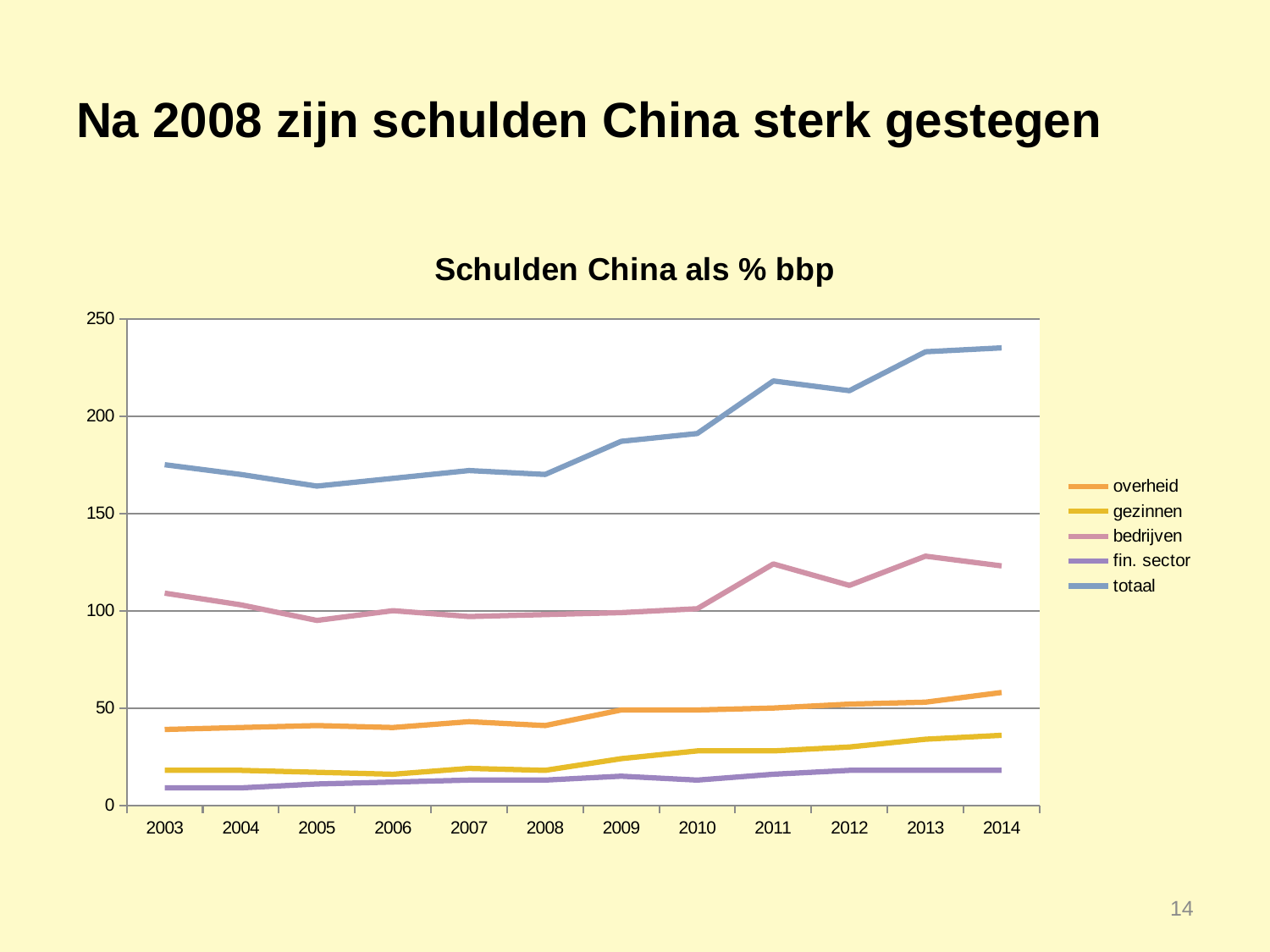
How many series does the legend list? 5 Which series has the lowest value in 2014? fin. sector What is the title of the chart? Schulden China als % bbp Is the value for totaal in 2005 greater or less than 200? less Is the value for totaal in 2014 greater or less than 200? greater Does the totaal series rise or fall from 2008 to 2014? rise Is the value for gezinnen in 2014 greater or less than 50? less What kind of chart is shown on the slide? line chart Which series has the highest value in 2014? totaal Which is larger, the value for bedrijven or for overheid in 2011? bedrijven How many years are shown on the x axis? 12